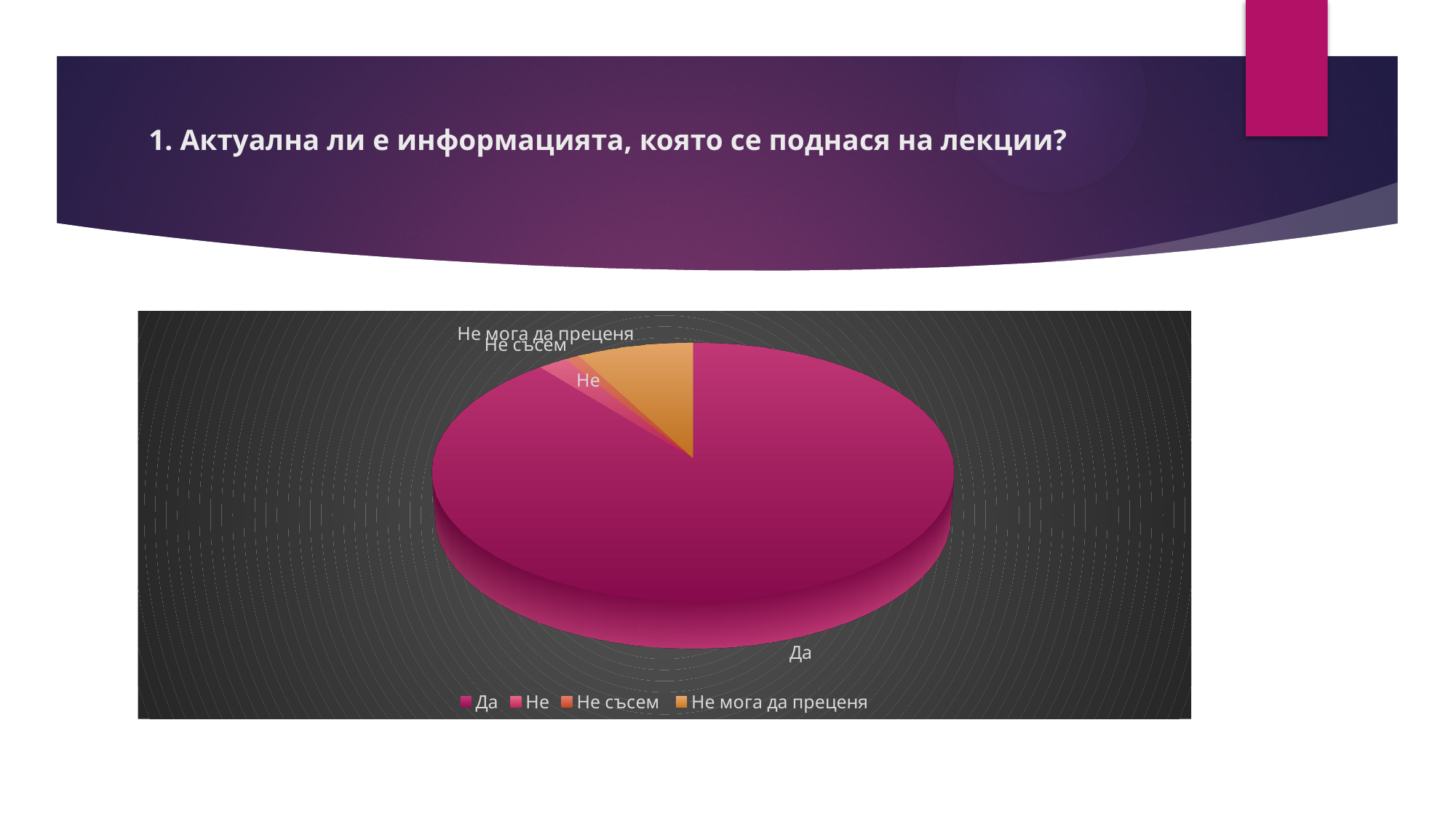
Which slice is larger, Не мога да преценя or Не? Не мога да преценя How many categories does the pie chart have? 4 Which category has the largest slice of the pie chart? Да What is the title of the slide above the chart? 1. Актуална ли е информацията, която се поднася на лекции? Which slice is larger, Да or Не мога да преценя? Да What colour is the Не мога да преценя slice in the pie chart? orange Does the Да slice take up more or less than half of the pie? more What kind of chart is shown on the slide? pie chart Which slice is larger, Да or Не съсем? Да